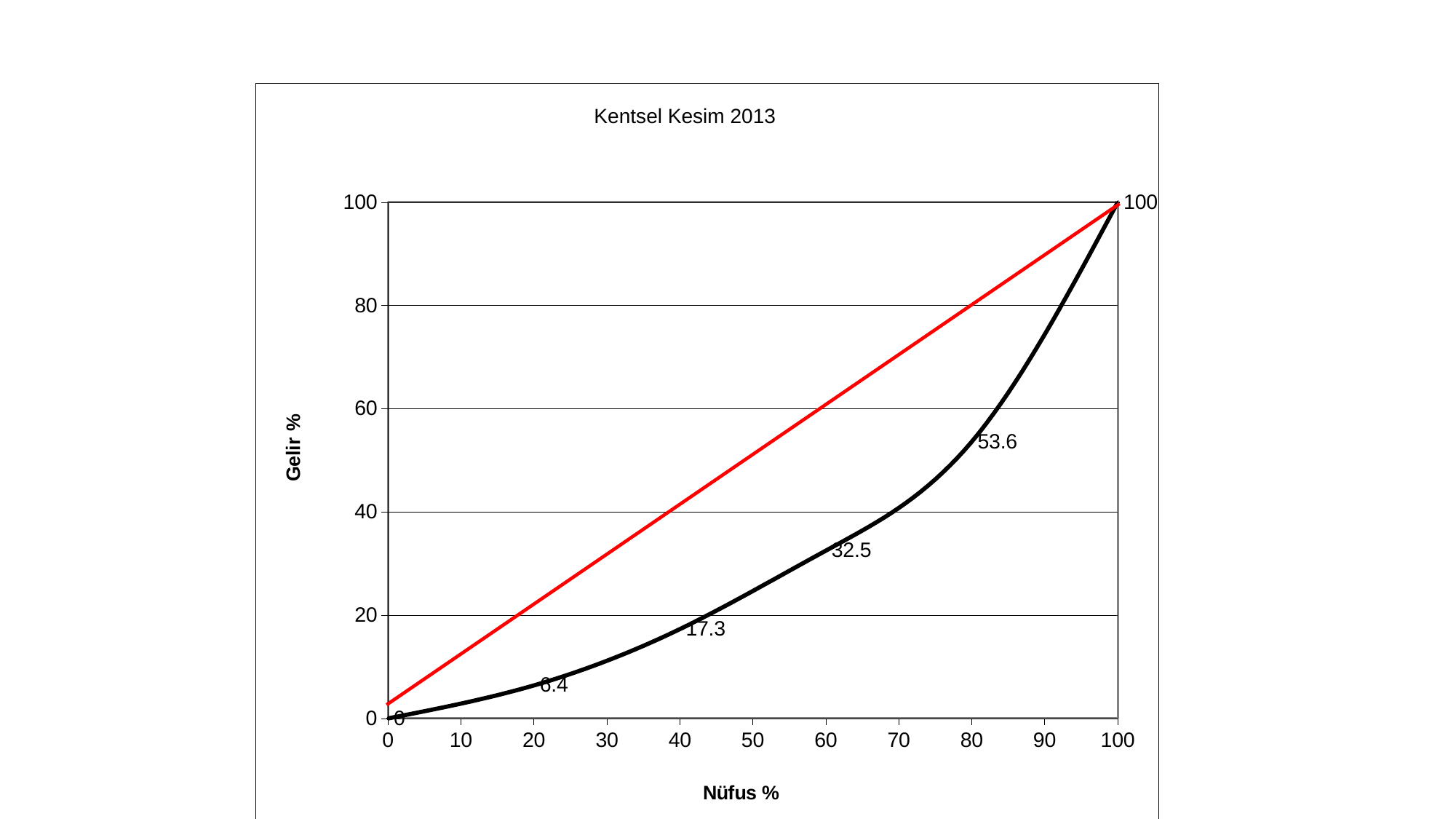
What is the title of the chart? Kentsel Kesim 2013 What is the difference between the black curve's values at Nüfus % 40 and Nüfus % 20? 10.9 Is the value of the black curve at Nüfus % 50 greater or less than 40? less What is the label of the vertical axis? Gelir % Does the black curve rise or fall as Nüfus % increases? rises What is the Gelir % value of the black curve at Nüfus % 80? 53.6 What is the Gelir % value of the black curve at Nüfus % 60? 32.5 What is the Gelir % value of the black curve at Nüfus % 20? 6.4 What type of chart is shown on the slide? line chart What is the Gelir % value of the black curve at Nüfus % 40? 17.3 How many labeled data points are on the black curve? 6 What is the difference between the black curve's values at Nüfus % 80 and Nüfus % 60? 21.1